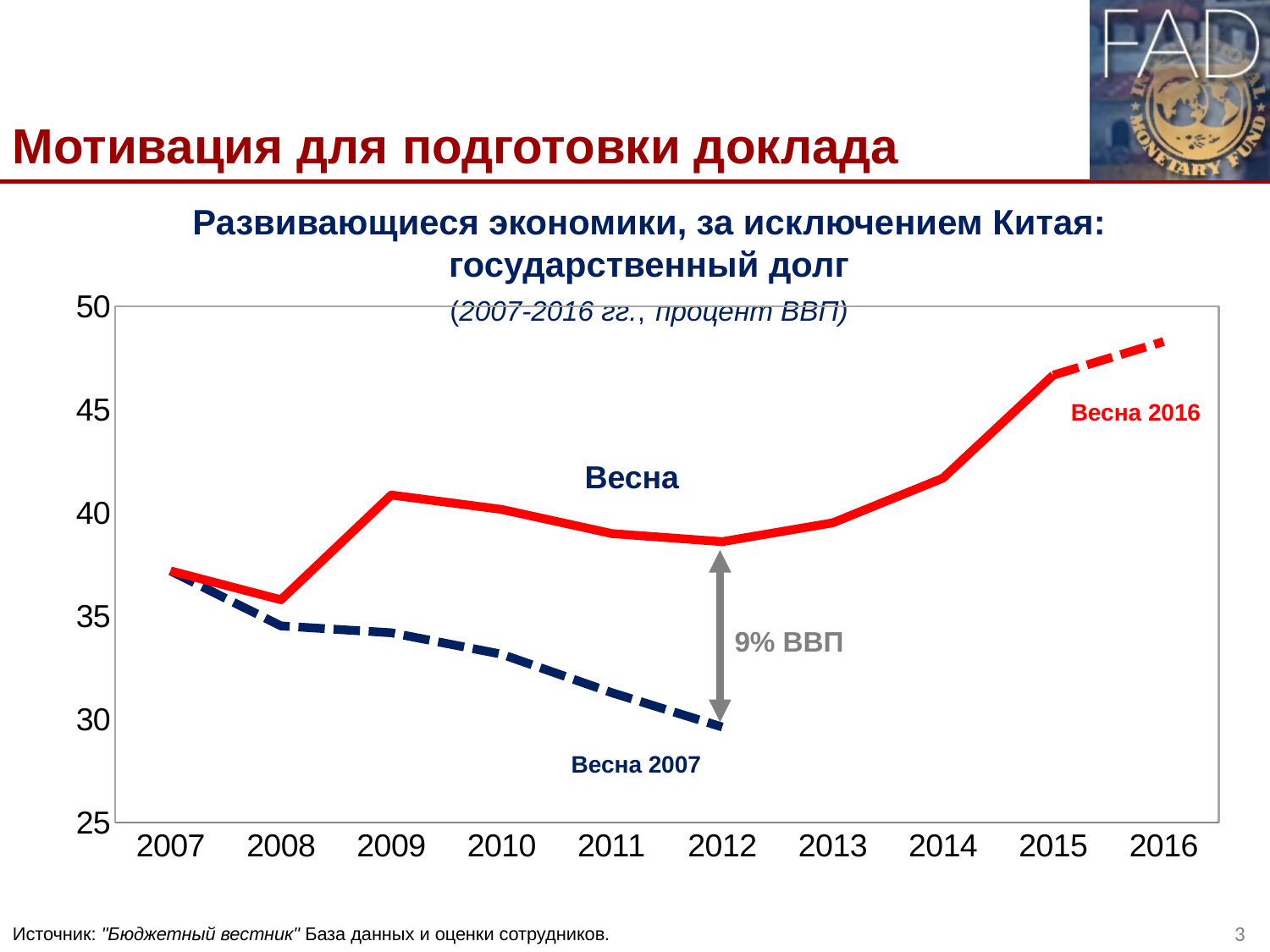
In which year does the Весна 2016 line reach its highest value? 2016 In which year does the Весна 2016 line reach its lowest value? 2008 Does the Весна 2016 line rise or fall from 2012 to 2016? rise Does the Весна 2007 line rise or fall from 2007 to 2012? fall In 2012, which line is higher: Весна 2016 or Весна 2007? Весна 2016 According to the annotation, what is the gap between the Весна 2016 and Весна 2007 lines in 2012? 9% ВВП What is the title of the chart? Развивающиеся экономики, за исключением Китая: государственный долг How many years are shown on the x axis? 10 Is the value of the Весна 2007 line in 2012 greater or less than 35? less How many lines (series) are labelled on the chart? 2 Is the value of the Весна 2016 line in 2015 greater or less than 45? greater What kind of chart is shown on the slide? line chart